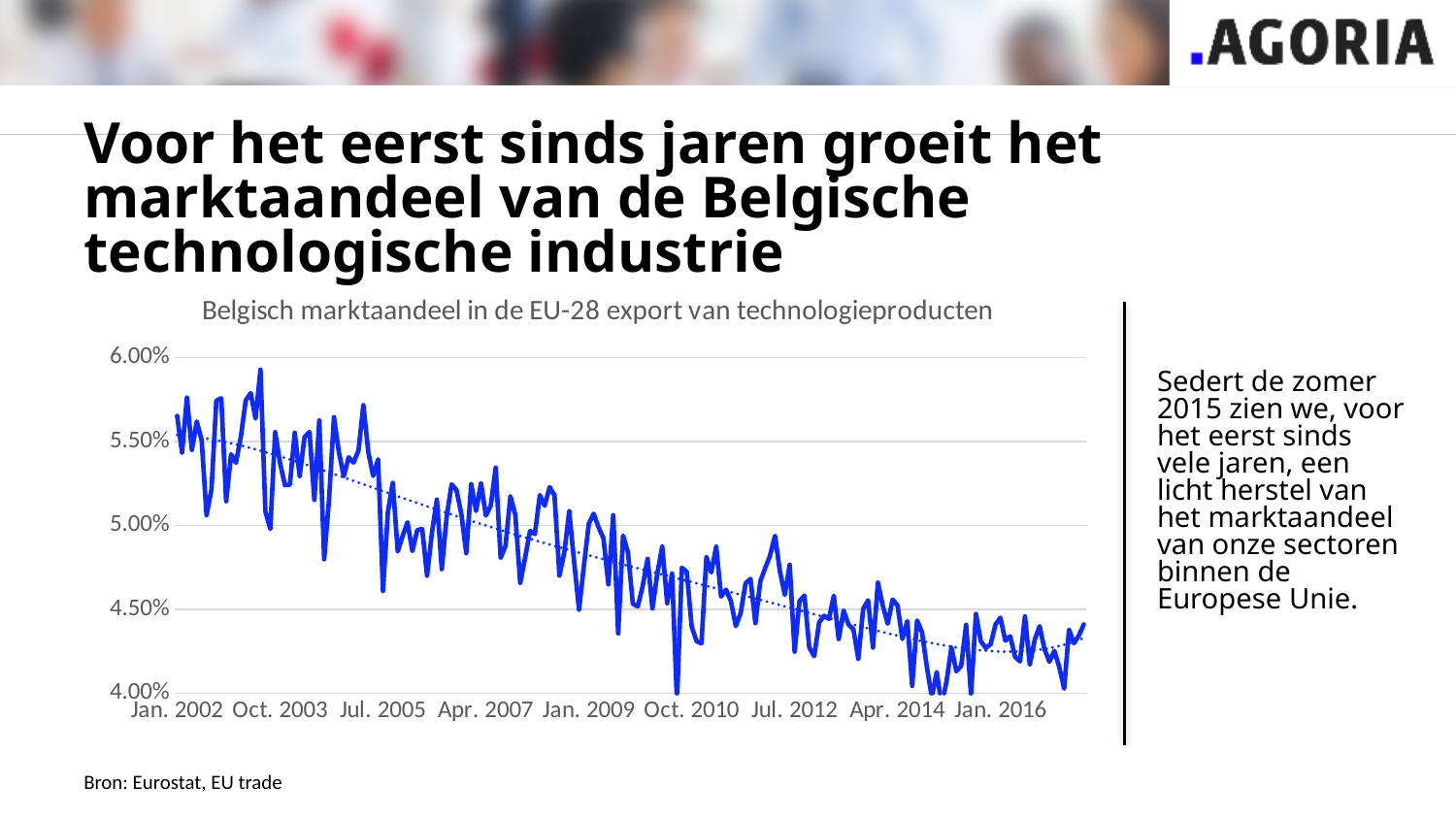
Is the value around Apr. 2014 greater or less than 5.00%? less Is the value around Jan. 2016 greater or less than 5.00%? less What is the title of the chart? Belgisch marktaandeel in de EU-28 export van technologieproducten What is the highest value shown on the y axis? 6.00% Which period has the higher market share: Jan. 2002 or Jan. 2016? Jan. 2002 What kind of chart is shown on the slide? line chart Is the value around Oct. 2003 greater or less than 4.50%? greater Does the Belgian market share generally rise or fall from Jan. 2002 to Jan. 2016? fall What is the lowest value shown on the y axis? 4.00% How many date labels are shown on the x axis? 9